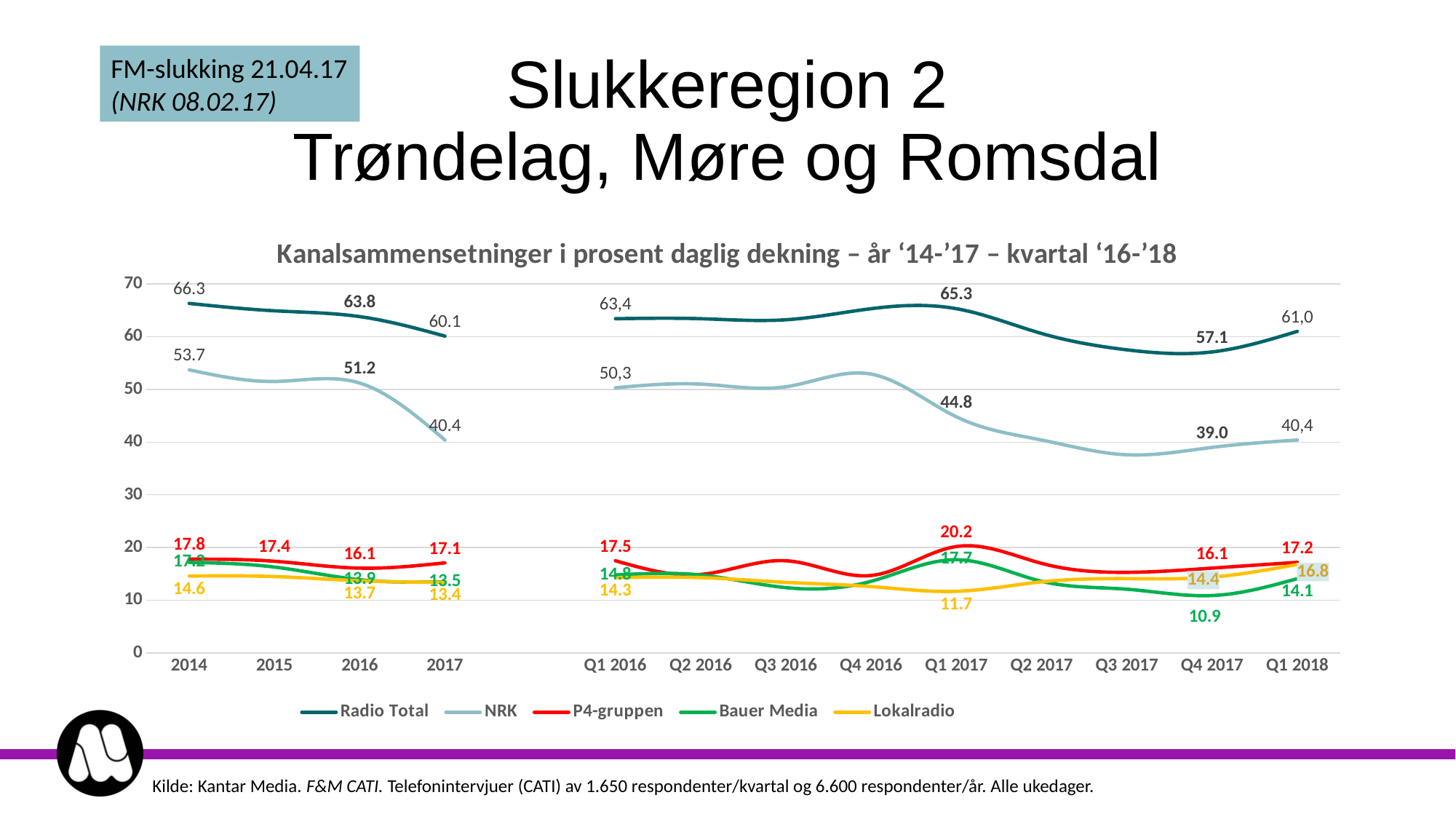
What is the value for NRK in Q4 2017? 39.0 What is the value for Lokalradio in Q1 2018? 16.8 Which is larger, the NRK value in 2016 or the NRK value in 2017? 2016 What kind of chart is shown on the slide? Line chart What is the value for Bauer Media in Q4 2017? 10.9 How many series does the legend list? 5 What is the difference between the Radio Total values for 2014 and 2017? 6.2 Is the value for Radio Total in Q3 2017 greater or less than 60? less Does the NRK line rise or fall from 2014 to 2017? Fall What is the value for Radio Total in 2014? 66.3 Which series has the highest value in Q1 2018? Radio Total What is the value for P4-gruppen in Q1 2017? 20.2